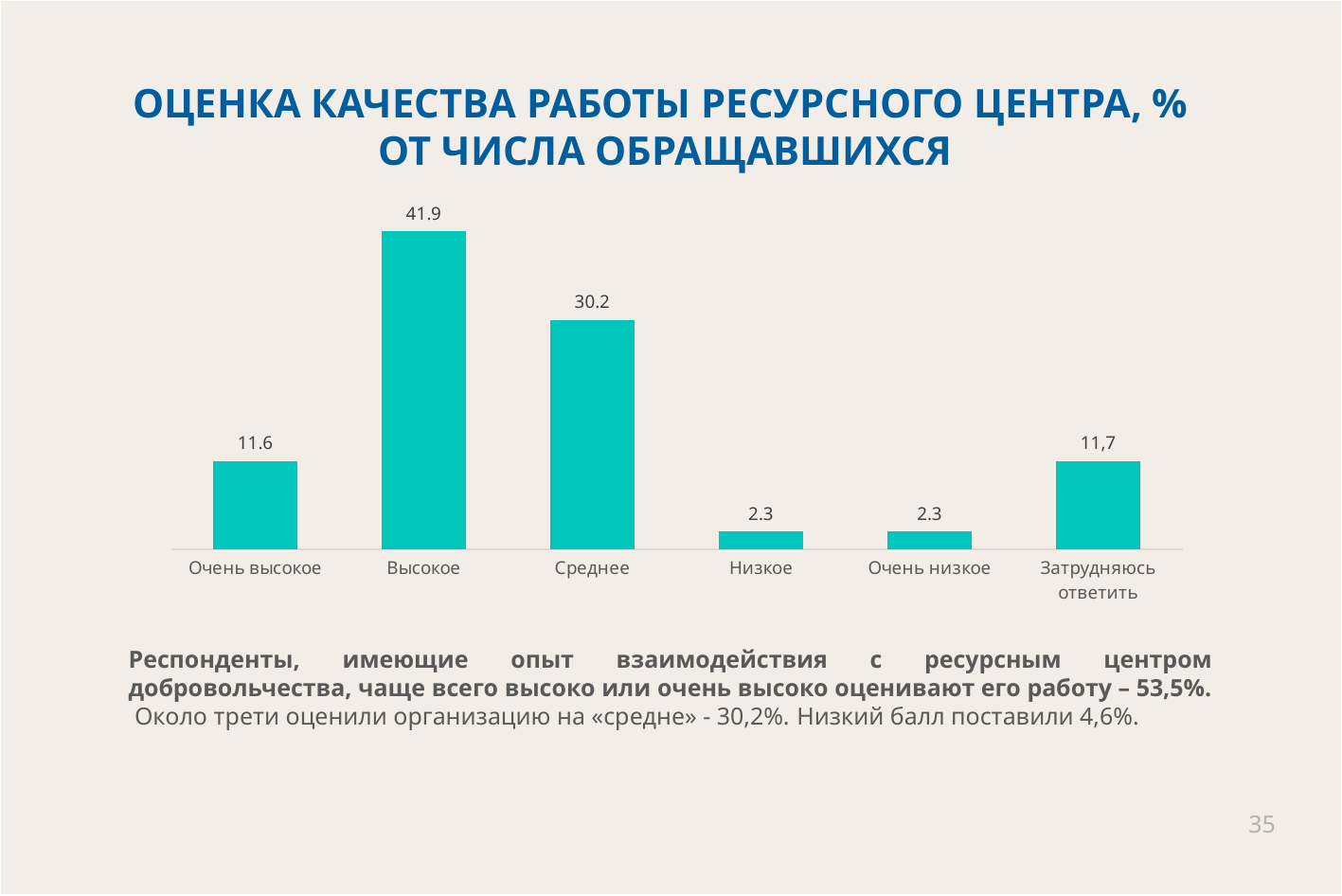
What is the value for Очень высокое? 11.6 What is the value for Низкое? 2.3 What is the value for Высокое? 41.9 What is the value for Среднее? 30.2 Which is larger, the value for Среднее or the value for Очень высокое? Среднее Which category has the highest value? Высокое What is the difference between the values for Высокое and Очень высокое? 30.3 What is the difference between the values for Высокое and Среднее? 11.7 What is the value for Затрудняюсь ответить? 11,7 What kind of chart is shown on the slide? bar chart How many categories are shown in the chart? 6 What is the lowest value shown in the chart? 2.3